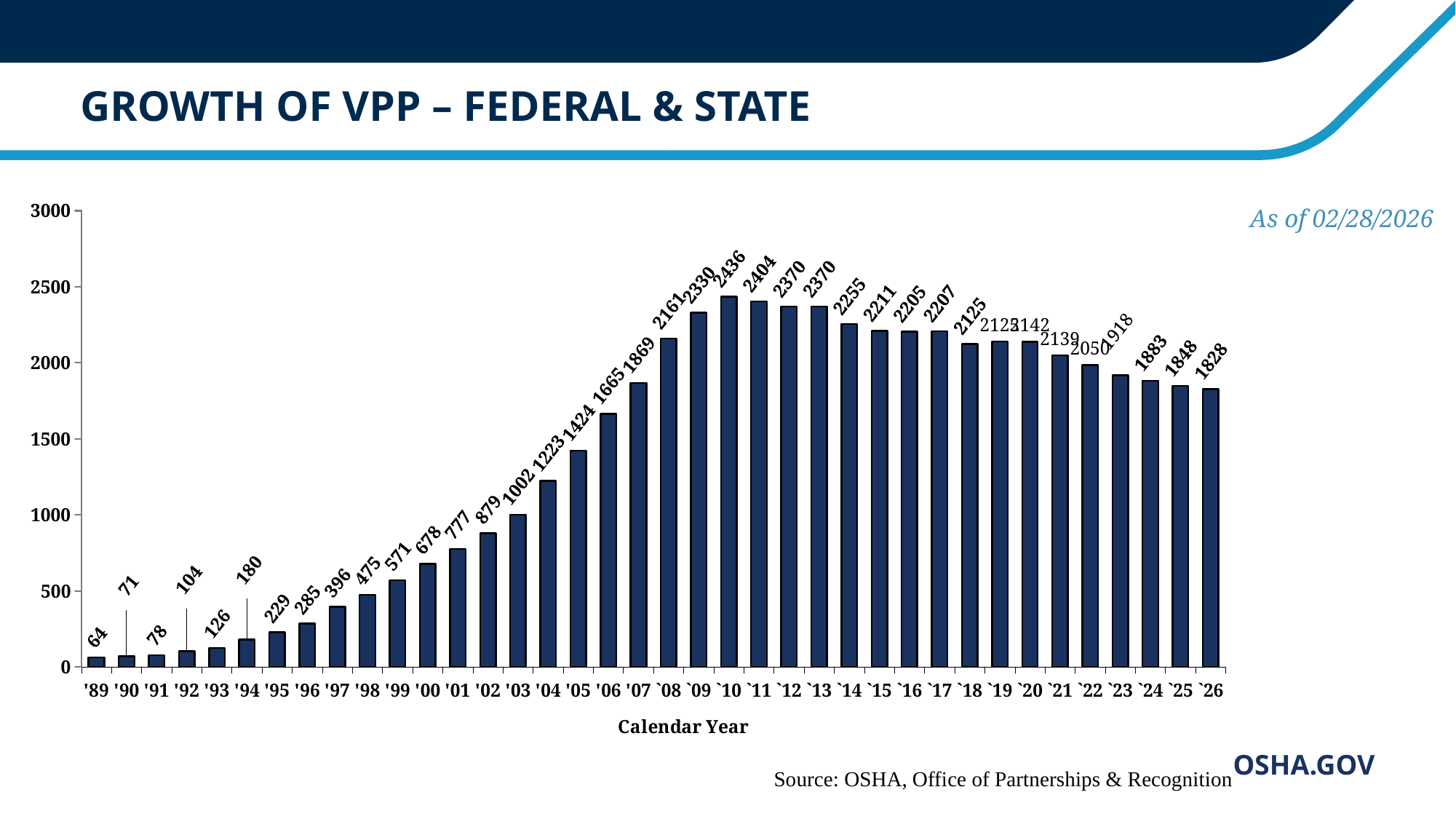
What kind of chart is shown on the slide? bar chart Do the values rise or fall from '89 to `10? rise What is the value for '89? 64 Which year has the highest value? `10 Is the value for '07 greater or less than 2000? less What is the value for `10? 2436 Which is larger, the value for `08 or the value for `09? `09 Which year has the lowest value? '89 How many years are shown on the x axis? 38 What is the difference between the values for `25 and `26? 20 What is the difference between the values for `10 and `26? 608 What is the value for '00? 678